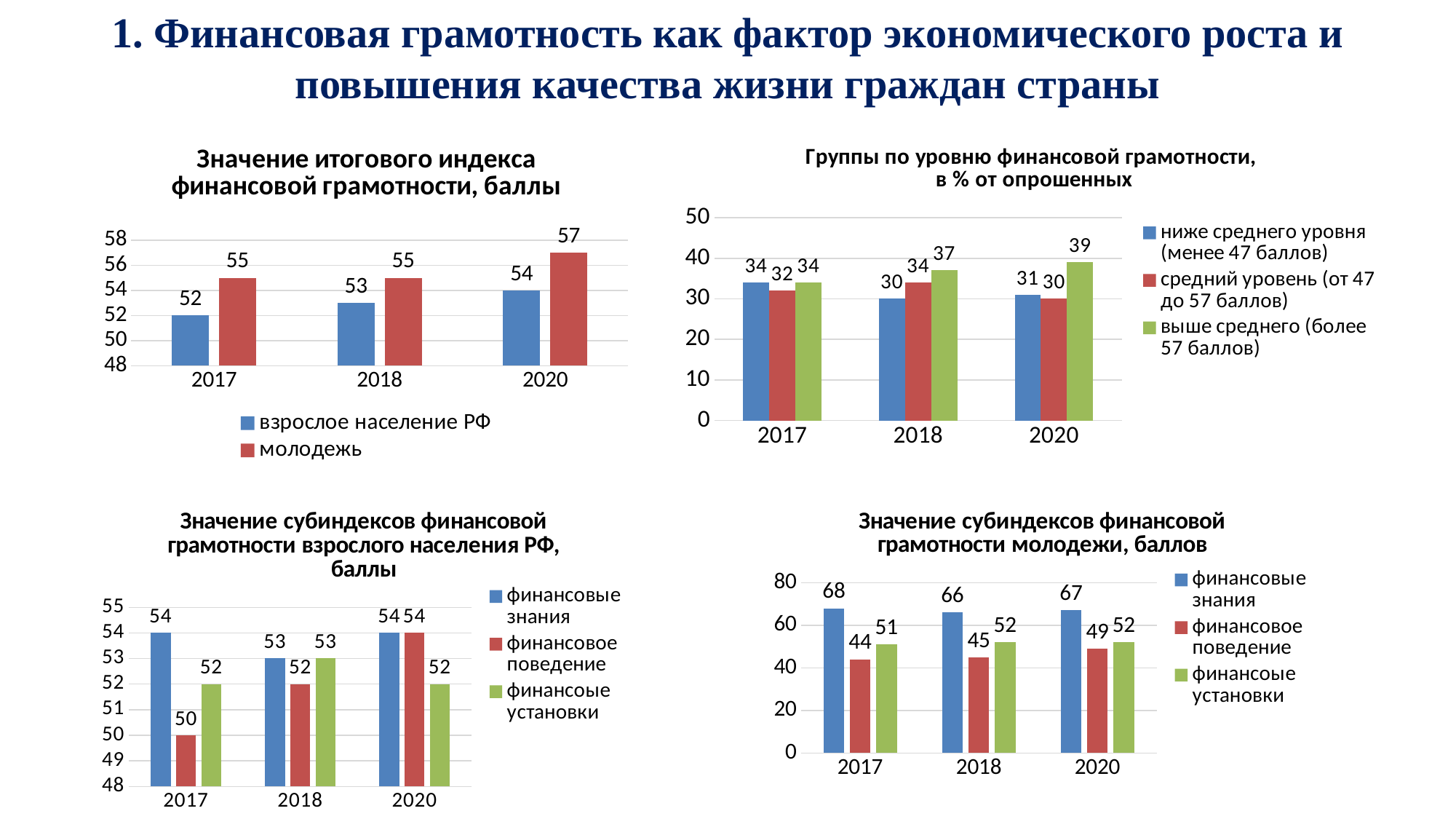
На диаграмме «Значение итогового индекса финансовой грамотности, баллы» какое значение у молодежи в 2020 году? 57 На диаграмме «Значение субиндексов финансовой грамотности молодежи, баллов» какое значение субиндекса «финансовые знания» в 2018 году? 66 На диаграмме «Значение итогового индекса финансовой грамотности, баллы» на сколько баллов значение молодежи превышает значение взрослого населения РФ в 2017 году? 3 На диаграмме «Значение субиндексов финансовой грамотности молодежи, баллов» на сколько баллов «финансовые знания» превышают «финансовое поведение» в 2017 году? 24 На диаграмме «Значение субиндексов финансовой грамотности взрослого населения РФ, баллы» какой субиндекс имеет наименьшее значение в 2020 году? финансоые установки Сколько рядов данных указано в легенде диаграммы «Группы по уровню финансовой грамотности, в % от опрошенных»? 3 На диаграмме «Группы по уровню финансовой грамотности, в % от опрошенных» какова доля группы «выше среднего (более 57 баллов)» в 2018 году? 37 На диаграмме «Группы по уровню финансовой грамотности, в % от опрошенных» в каком году доля группы «выше среднего (более 57 баллов)» наибольшая? 2020 На диаграмме «Значение субиндексов финансовой грамотности взрослого населения РФ, баллы» какое значение субиндекса «финансовое поведение» в 2017 году? 50 На диаграмме «Значение итогового индекса финансовой грамотности, баллы» как меняется значение для взрослого населения РФ от 2017 к 2020 году? растет Какого типа диаграмма «Значение субиндексов финансовой грамотности молодежи, баллов»? столбчатая (bar chart) На диаграмме «Группы по уровню финансовой грамотности, в % от опрошенных» что больше в 2020 году: доля группы «ниже среднего уровня» или «выше среднего»? выше среднего